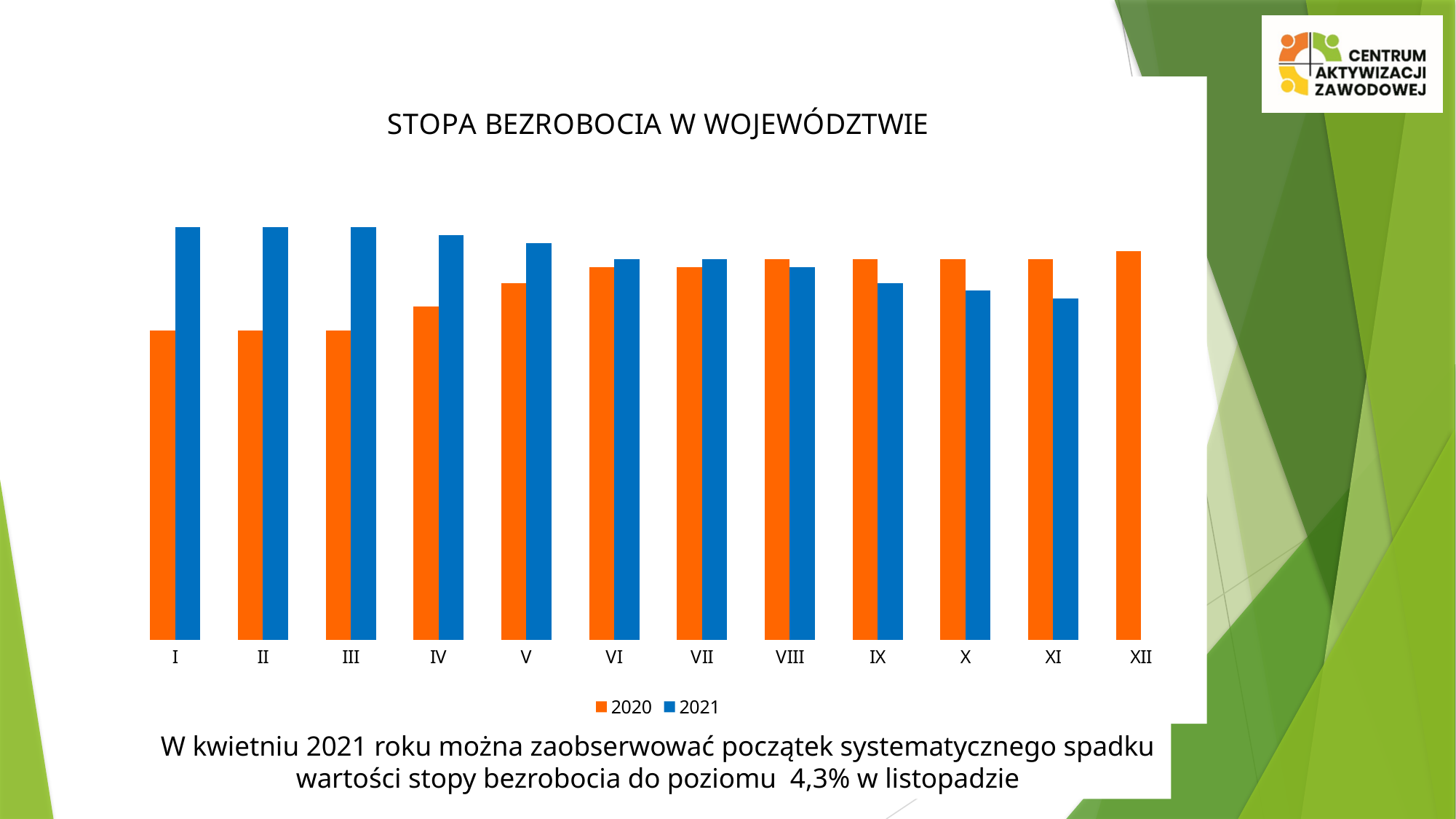
How many categories (months) are shown on the x axis? 12 In month IX, which series has the larger value, 2020 or 2021? 2020 Do the values for the 2021 series rise or fall from month IV to month XI? fall How many series does the legend list? 2 For how many months is a 2021 bar plotted? 11 In month I, which series has the larger value, 2020 or 2021? 2021 What is the title of the chart? STOPA BEZROBOCIA W WOJEWÓDZTWIE Which colour represents the 2020 series in the legend? orange What kind of chart is shown on the slide? bar chart Which month has the lowest value for the 2021 series? XI Do the values for the 2020 series rise or fall from month III to month VIII? rise In month XI, which series has the larger value, 2020 or 2021? 2020